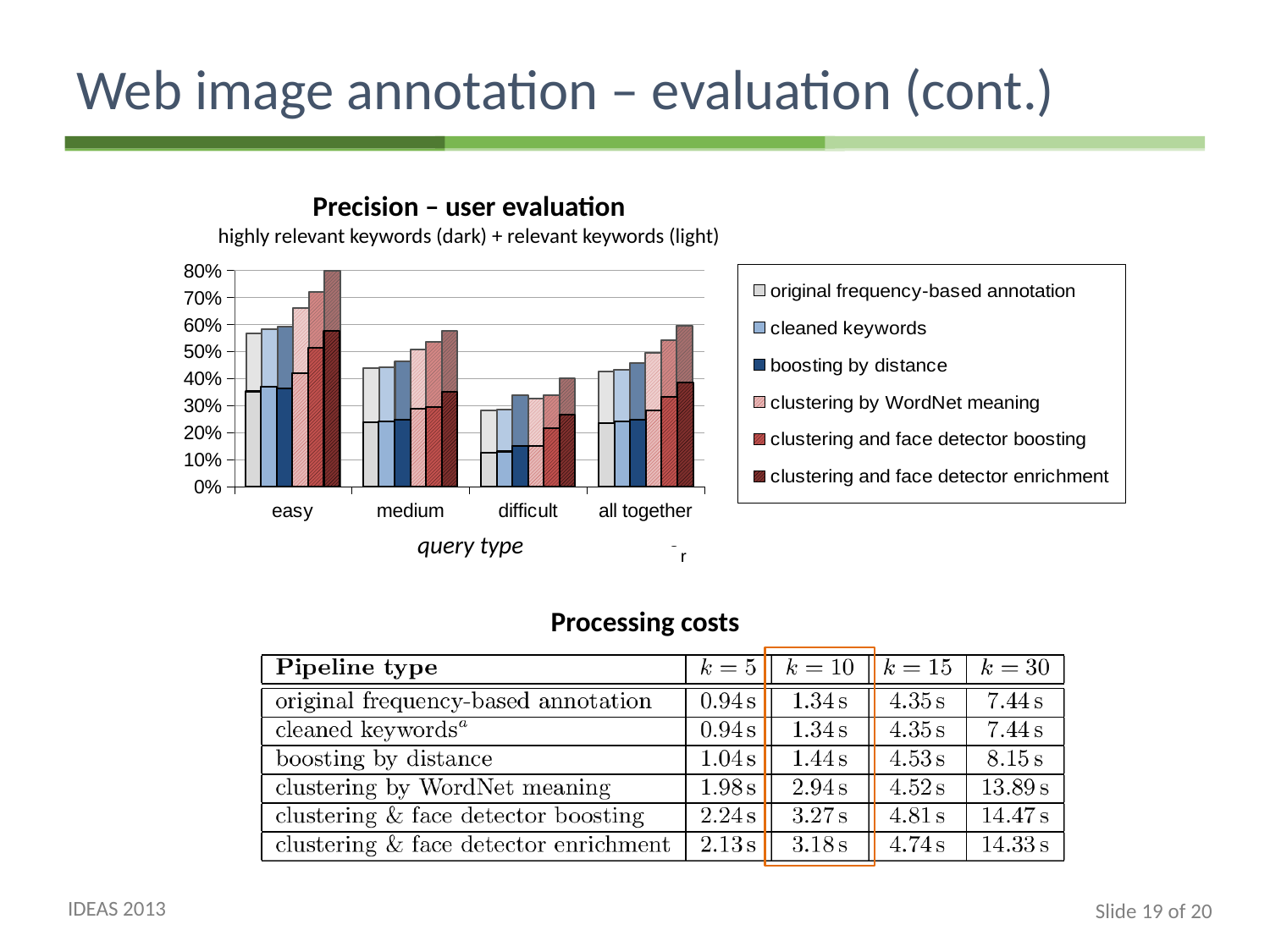
In the "Precision – user evaluation" chart, which is larger for easy queries: "original frequency-based annotation" or "clustering and face detector enrichment"? clustering and face detector enrichment In the "Precision – user evaluation" chart, which query type has the lowest precision values? difficult What is the first entry in the legend of the "Precision – user evaluation" chart? original frequency-based annotation In the "Precision – user evaluation" chart, is the value for "original frequency-based annotation" on difficult queries greater or less than 40%? less How many query types are shown on the x axis of the "Precision – user evaluation" chart? 4 In the "Precision – user evaluation" chart, is the value for "original frequency-based annotation" on easy queries greater or less than 50%? greater How many series does the legend of the "Precision – user evaluation" chart list? 6 In the "Precision – user evaluation" chart, which query type has the highest precision values? easy In the "Precision – user evaluation" chart, do the values for "cleaned keywords" rise or fall going from easy to medium to difficult? fall What kind of chart is shown under the title "Precision – user evaluation"? bar chart In the "Precision – user evaluation" chart, is the value for "clustering and face detector enrichment" on medium queries greater or less than 50%? greater What is the x-axis label of the "Precision – user evaluation" chart? query type